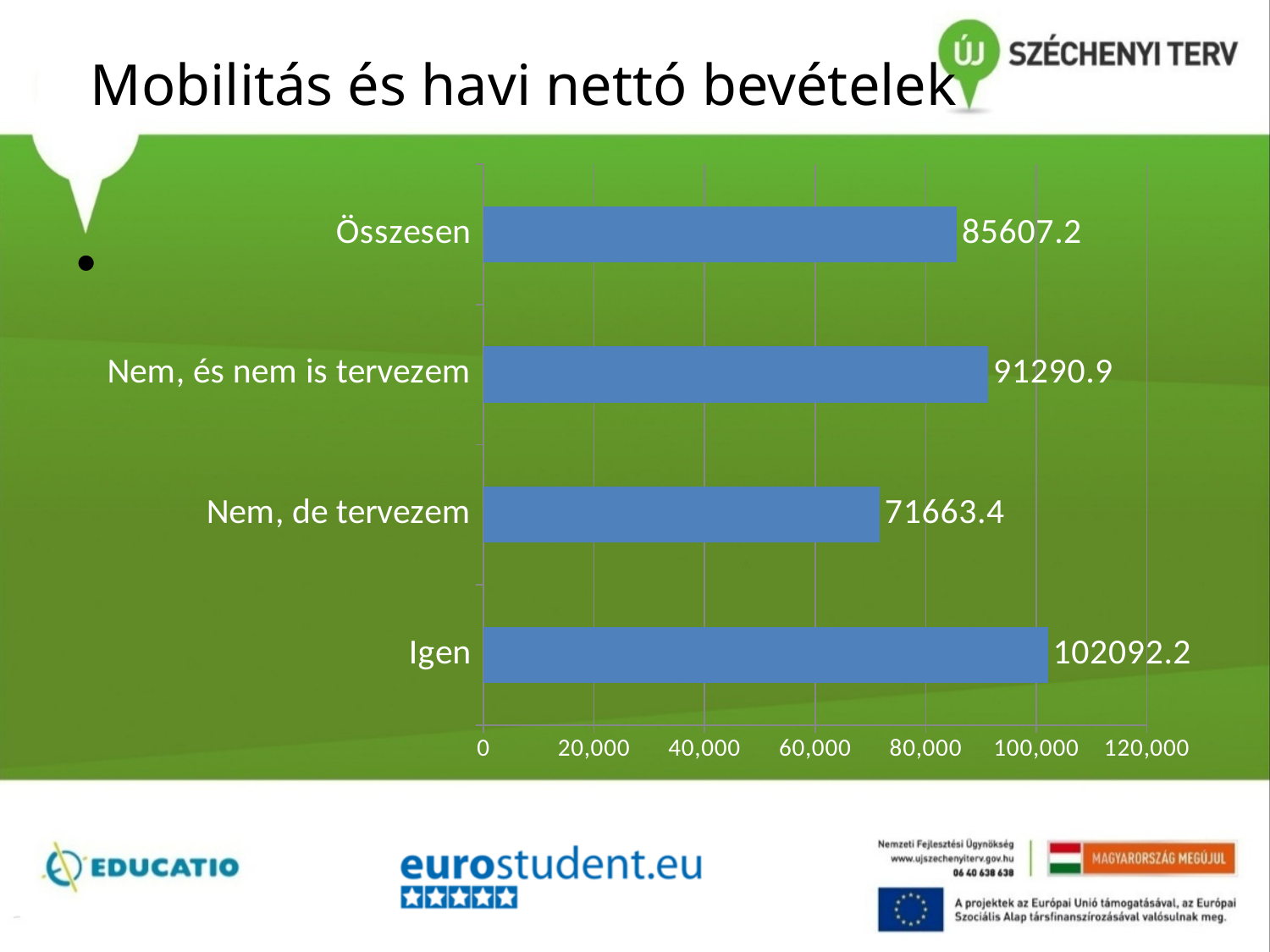
What is the value for "Nem, de tervezem"? 71663.4 What is the value for "Összesen"? 85607.2 What is the difference between the values for "Igen" and "Nem, de tervezem"? 30428.8 Which is larger, the value for "Összesen" or the value for "Nem, és nem is tervezem"? Nem, és nem is tervezem What kind of chart is shown on the slide? bar chart What is the difference between the values for "Nem, és nem is tervezem" and "Összesen"? 5683.7 What is the value for "Igen"? 102092.2 Which category has the highest value? Igen Which category has the lowest value? Nem, de tervezem How many categories are shown in the chart? 4 Is the value for "Igen" greater or less than 100,000? greater What is the value for "Nem, és nem is tervezem"? 91290.9